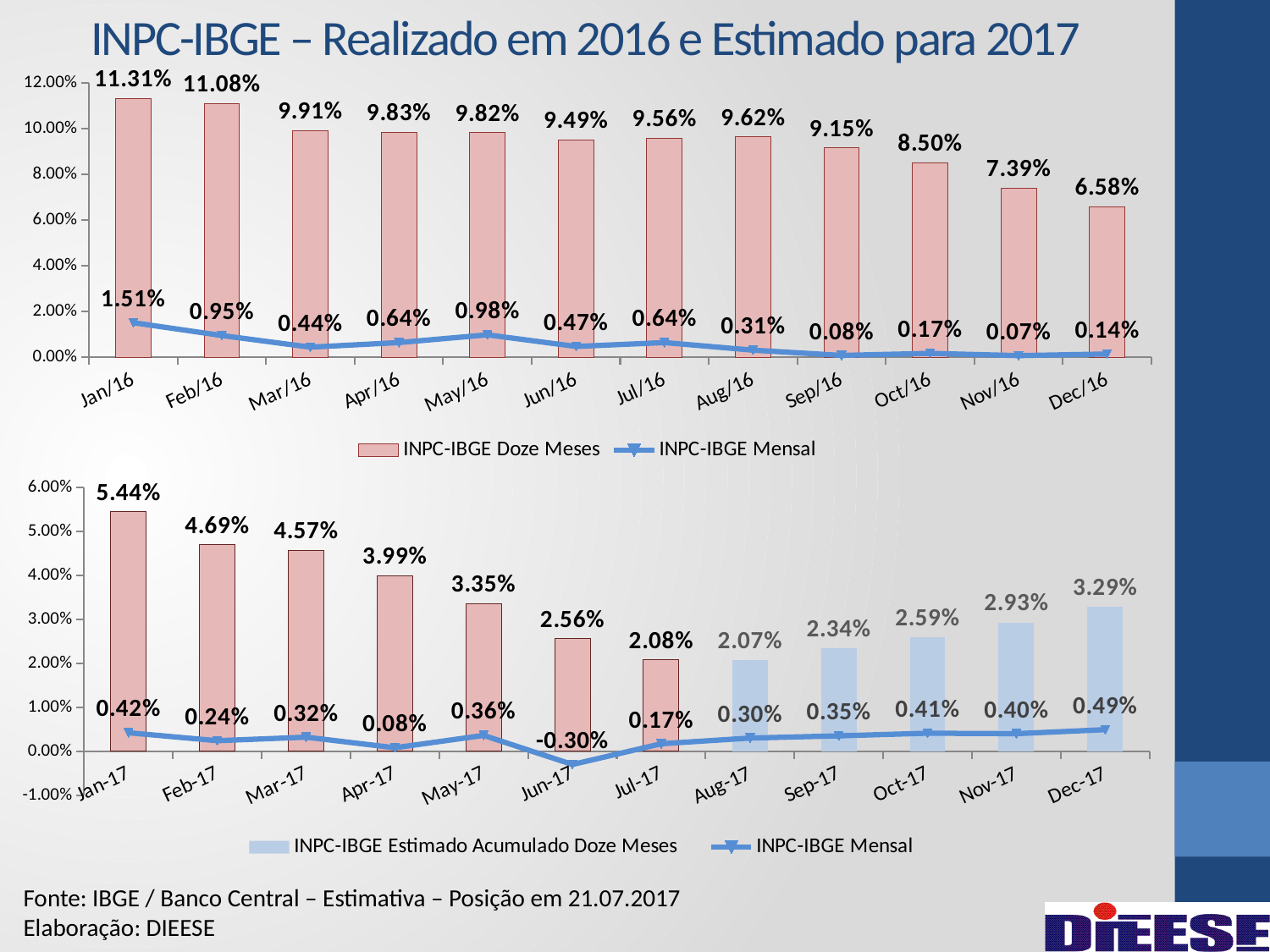
In the top chart (2016), which month has the highest INPC-IBGE Mensal value? Jan/16 In the bottom chart (2017), what is the INPC-IBGE Mensal value for Jun-17? -0.30% In the top chart (2016), what is the difference between the INPC-IBGE Doze Meses values for Jan/16 and Dec/16? 4.73% In the bottom chart (2017), which month has the lowest twelve-month accumulated bar value? Aug-17 In the top chart (2016), what is the INPC-IBGE Doze Meses value for Jan/16? 11.31% In the bottom chart (2017), what is the INPC-IBGE Estimado Acumulado Doze Meses value for Dec-17? 3.29% In the top chart (2016), what is the INPC-IBGE Mensal value for May/16? 0.98% In the top chart (2016), which month has the lowest INPC-IBGE Doze Meses value? Dec/16 In the top chart (2016), how many series does the legend list? 2 In the bottom chart (2017), how many months are shown on the x axis? 12 In the bottom chart (2017), what is the difference between the INPC-IBGE Mensal values for Dec-17 and Jan-17? 0.07% In the bottom chart (2017), is the bar value for Jan-17 larger or smaller than the bar value for Jul-17? larger